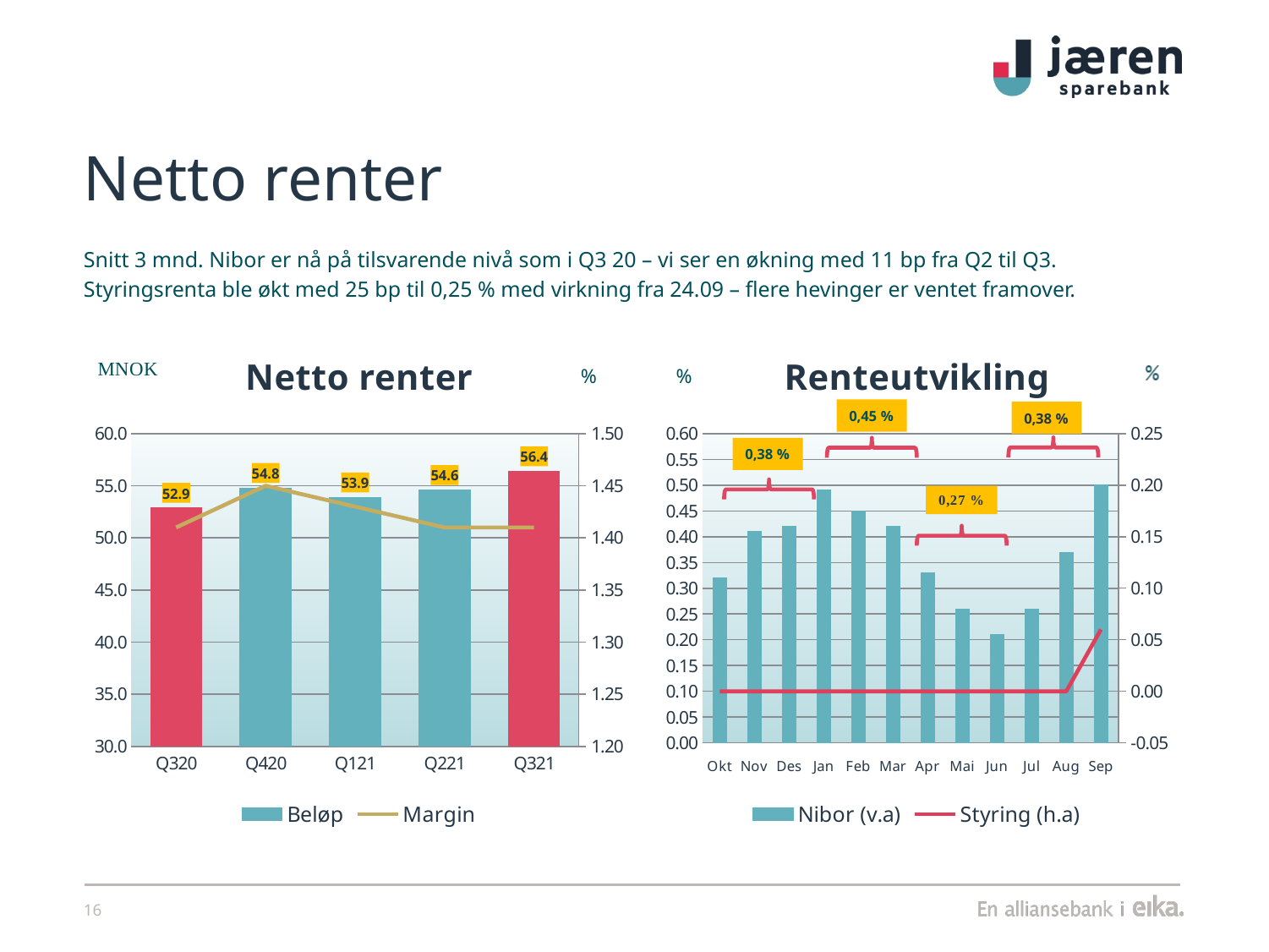
In the Renteutvikling chart, is the Nibor value for Jun greater or less than 0.25? less In the Netto renter chart, which quarter has the highest Beløp? Q321 What kind of chart is the Renteutvikling chart? Bar chart with a line How many series does the legend of the Netto renter chart list? 2 In the Renteutvikling chart, which month has the lowest Nibor value? Jun In the Netto renter chart, what is the Beløp value for Q321? 56.4 In the Netto renter chart, which quarter has the lowest Beløp? Q320 In the Netto renter chart, which is larger, the Beløp for Q420 or for Q121? Q420 In the Netto renter chart, what is the Beløp value for Q420? 54.8 In the Netto renter chart, what is the difference between the Beløp values for Q321 and Q221? 1.8 How many quarters are shown on the x axis of the Netto renter chart? 5 How many months are shown on the x axis of the Renteutvikling chart? 12